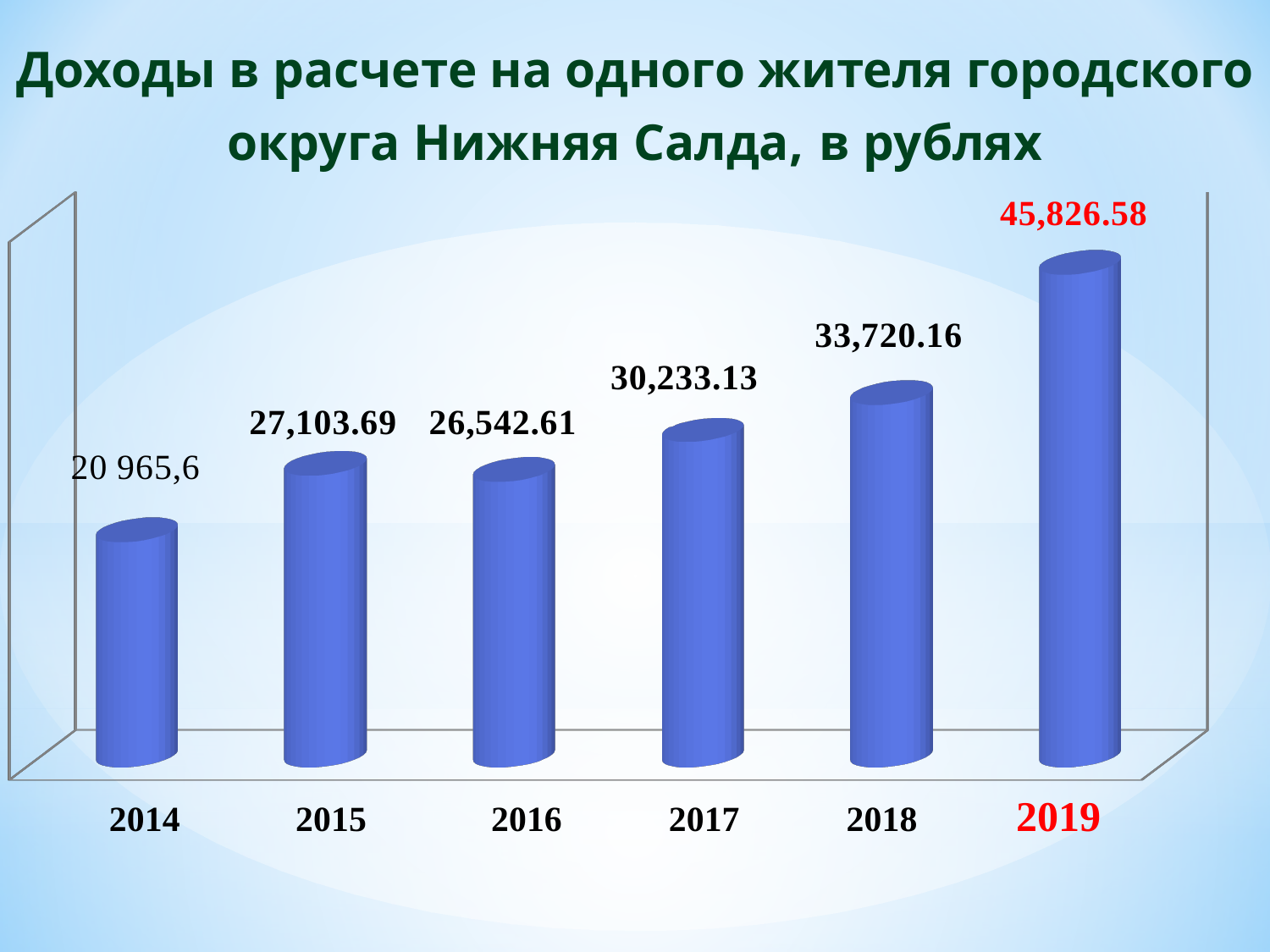
What is the value for 2017? 30,233.13 What is the value for 2019? 45,826.58 What is the difference between the values for 2019 and 2018? 12,106.42 What kind of chart is shown on the slide? Bar chart Which year's label and value are shown in red? 2019 What is the value for 2018? 33,720.16 Which year has the highest value? 2019 Which is larger, the value for 2015 or the value for 2016? 2015 What is the value for 2014? 20 965,6 How many years are shown on the chart? 6 Which year has the lowest value? 2014 What is the difference between the values for 2015 and 2016? 561.08